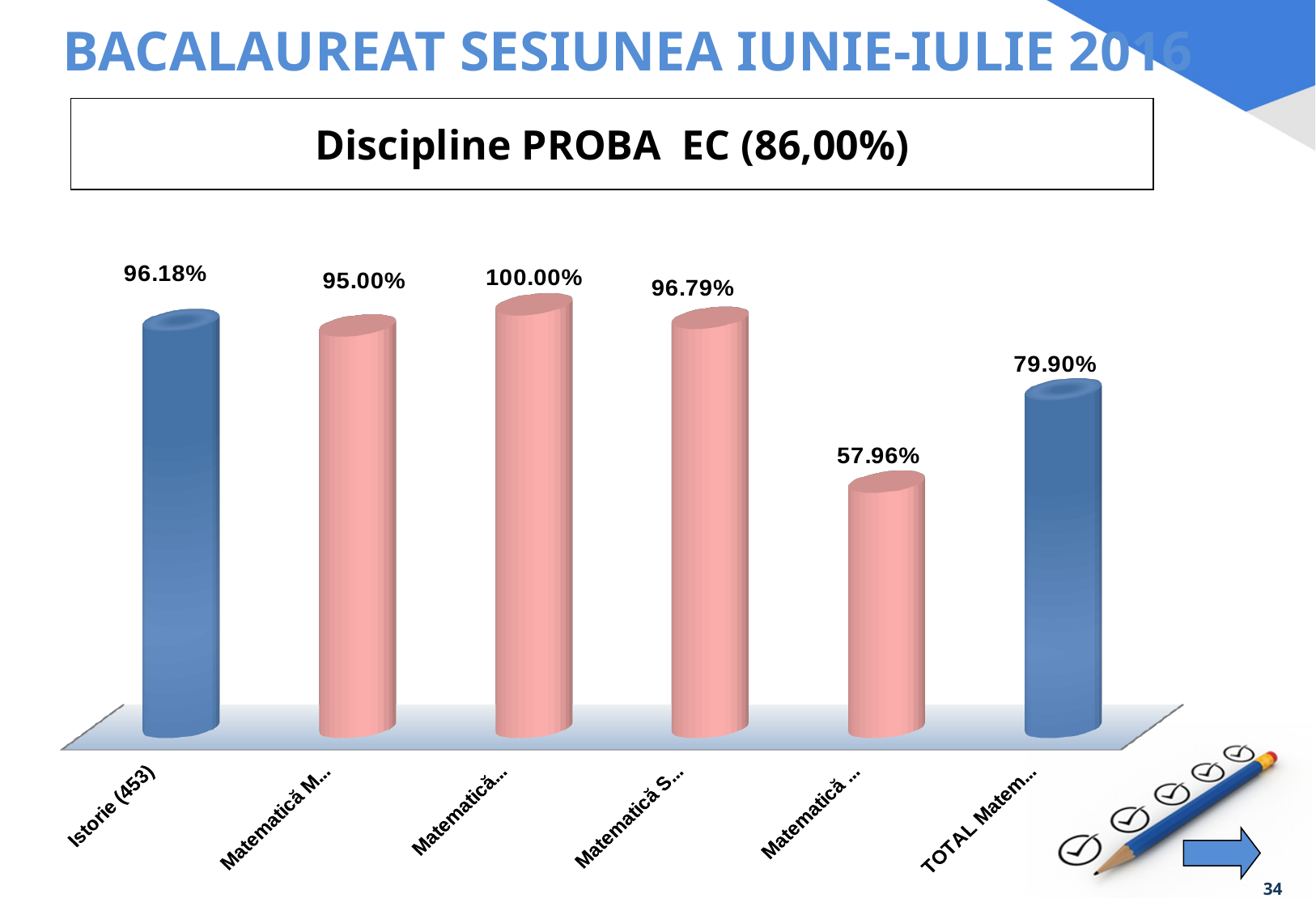
What is the difference between the value for Istorie (453) and the value of the last bar (TOTAL Matem...)? 16.28% Which bar has the lowest value? the fifth bar (57.96%) What is the value of the second bar from the left? 95.00% What is the value of the third bar from the left? 100.00% What is the value of the fifth bar from the left? 57.96% What is the value of the last bar on the right (TOTAL Matem...)? 79.90% What kind of chart is shown on the slide? bar chart Which is larger, the value for Istorie (453) or the value of the fourth bar from the left? the fourth bar (96.79%) Which bar has the highest value? the third bar (100.00%) What percentage is shown in the chart title box? 86,00% How many bars are plotted in the chart? 6 What is the value for Istorie (453)? 96.18%